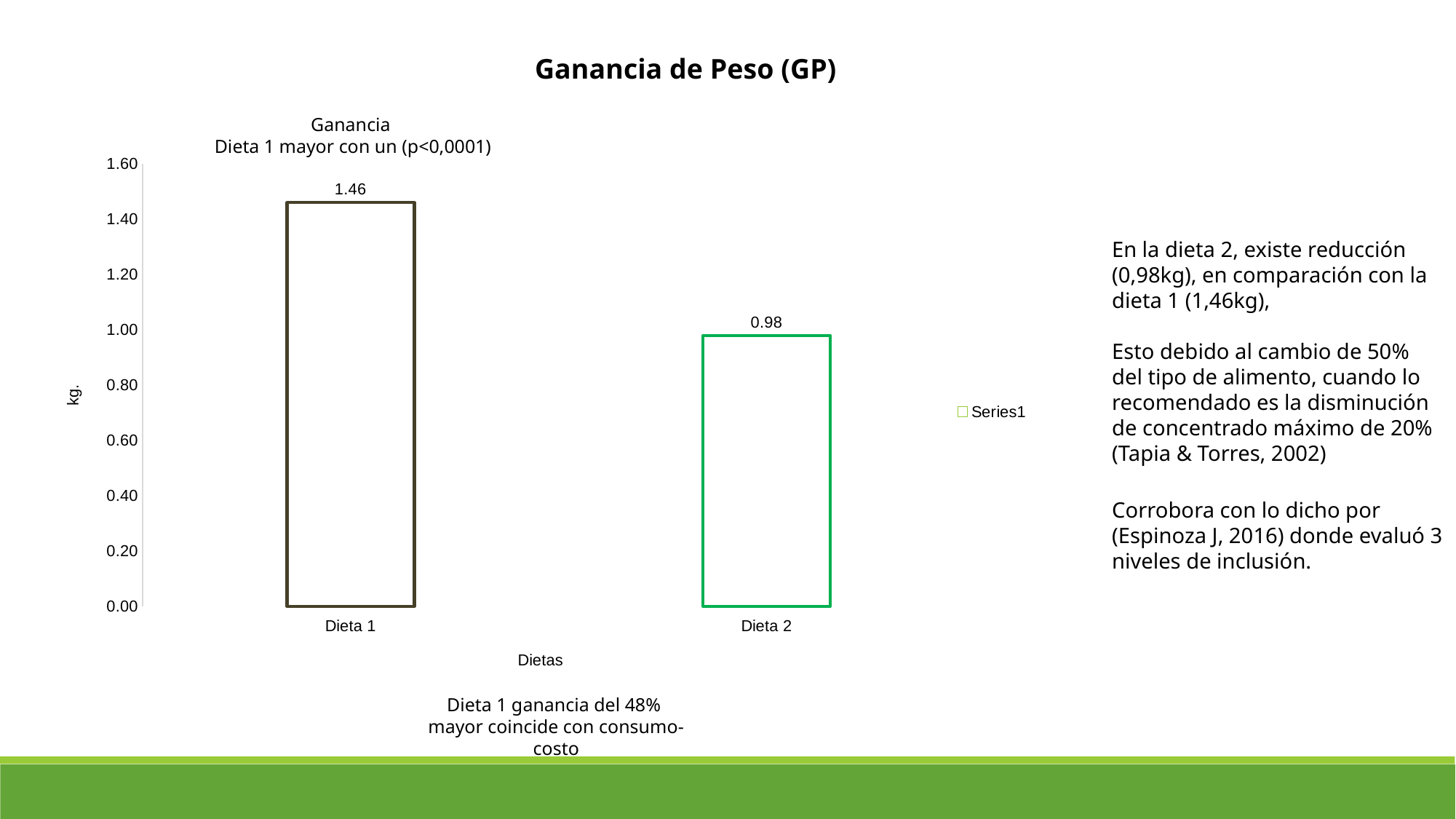
Which diet has the lowest weight gain? Dieta 2 What kind of chart is shown? bar chart What is the value for Dieta 2? 0.98 Is the value for Dieta 2 greater or less than 1.00? less How many categories are shown on the x axis? 2 What is the value for Dieta 1? 1.46 Which diet has the highest weight gain? Dieta 1 What is the label of the y axis? kg. What is the difference between the values for Dieta 1 and Dieta 2? 0.48 How many series does the legend list? 1 Which is larger, the value for Dieta 1 or Dieta 2? Dieta 1 Is the value for Dieta 1 greater or less than 1.40? greater